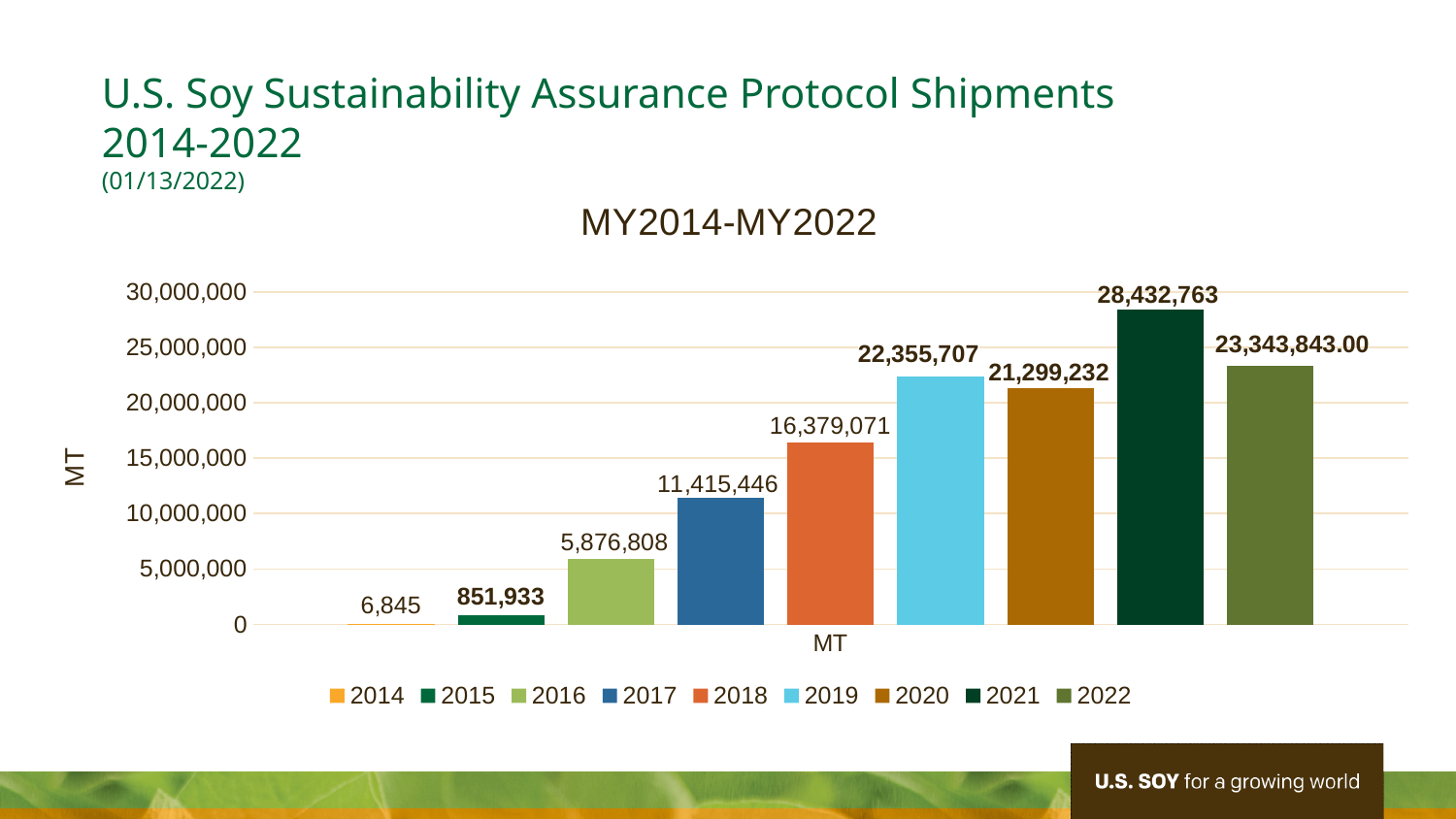
What is the difference between the 2021 and 2022 values in the MY2014-MY2022 chart? 5,088,920 Which is larger in the MY2014-MY2022 chart, the value for 2019 or the value for 2020? 2019 Which year has the highest value in the MY2014-MY2022 chart? 2021 Do the values in the MY2014-MY2022 chart rise or fall from 2014 to 2018? rise Is the value for 2018 in the MY2014-MY2022 chart greater or less than 15,000,000? greater What is the value for 2016 in the MY2014-MY2022 chart? 5,876,808 What is the value for 2021 in the MY2014-MY2022 chart? 28,432,763 What is the difference between the 2019 and 2020 values in the MY2014-MY2022 chart? 1,056,475 Which year has the lowest value in the MY2014-MY2022 chart? 2014 How many series does the legend of the MY2014-MY2022 chart list? 9 What is the value for 2022 in the MY2014-MY2022 chart? 23,343,843.00 What kind of chart is the MY2014-MY2022 chart? bar chart